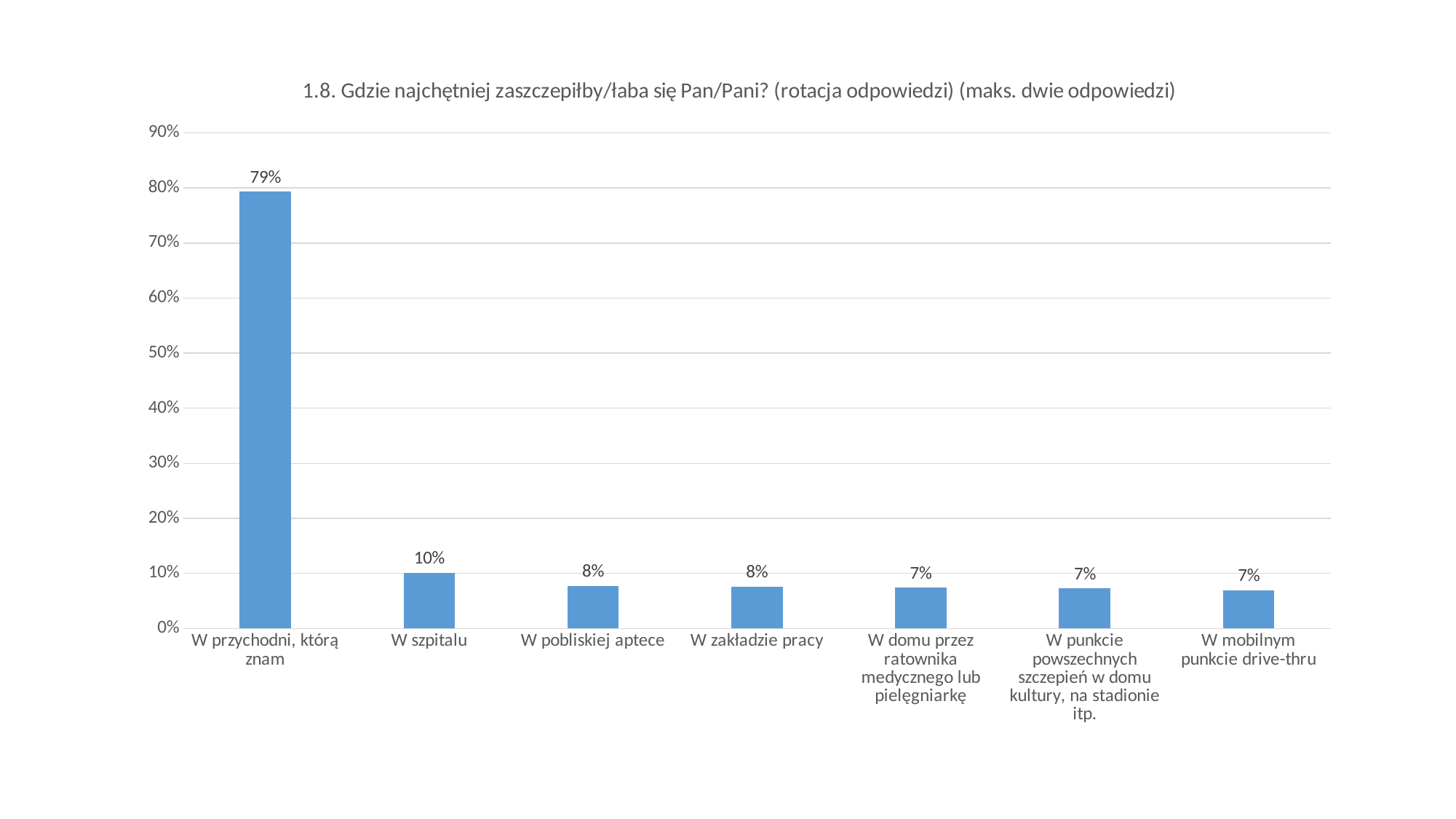
What is the title of the chart? 1.8. Gdzie najchętniej zaszczepiłby/łaba się Pan/Pani? (rotacja odpowiedzi) (maks. dwie odpowiedzi) What is the difference between the values for "W przychodni, którą znam" and "W szpitalu"? 69% What kind of chart is shown on the slide? bar chart How many categories are shown on the x axis? 7 What is the value for "W pobliskiej aptece"? 8% Which is larger, the value for "W szpitalu" or the value for "W domu przez ratownika medycznego lub pielęgniarkę"? W szpitalu What is the value for "W przychodni, którą znam"? 79% Which category has the highest value? W przychodni, którą znam What is the value for "W szpitalu"? 10% Is the value for "W przychodni, którą znam" greater or less than 70%? greater What is the value for "W mobilnym punkcie drive-thru"? 7% What is the difference between the values for "W szpitalu" and "W zakładzie pracy"? 2%